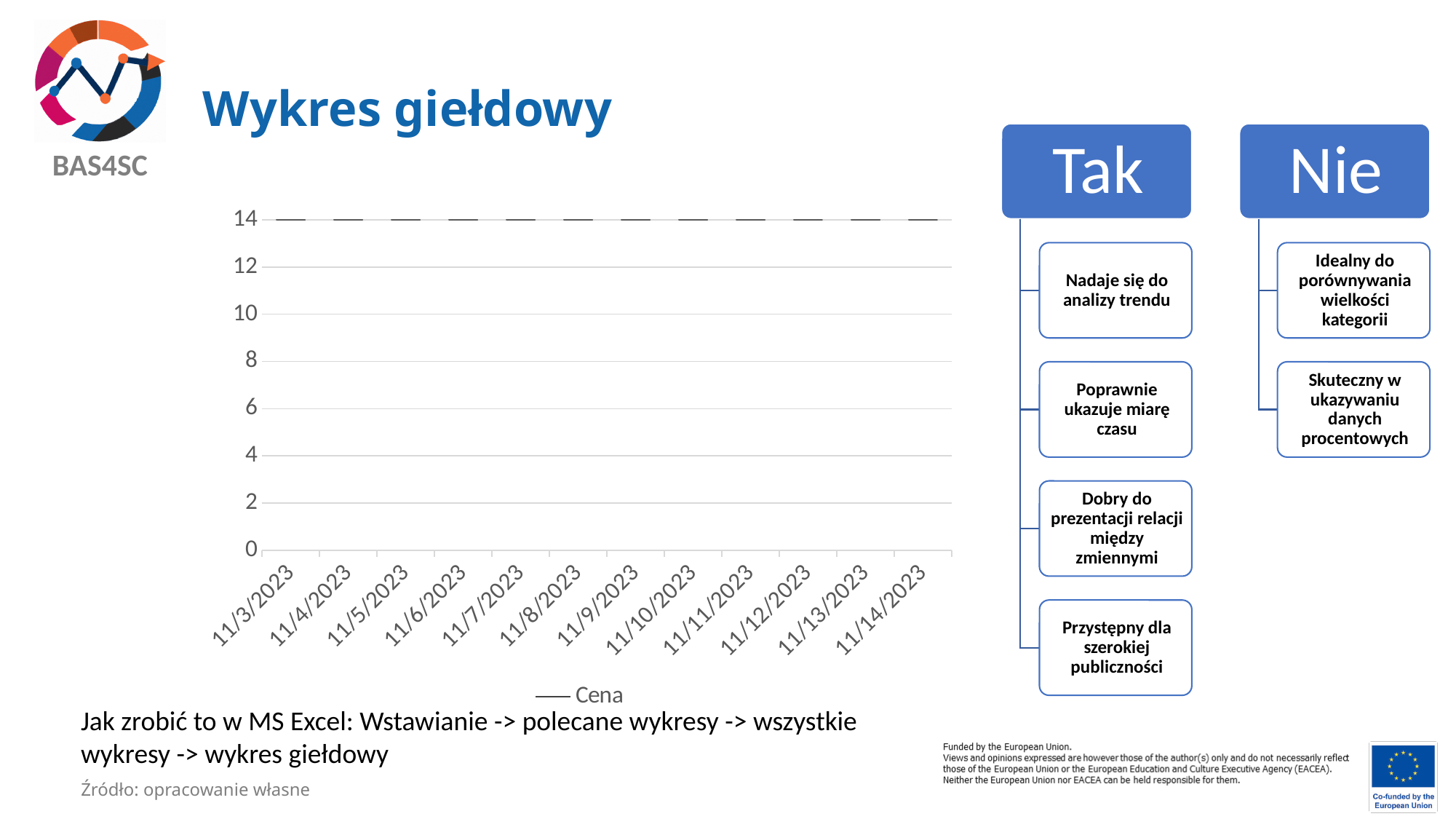
What is the name of the series shown in the chart legend? Cena What kind of chart is shown on the slide? stock chart What is the lowest value labelled on the y axis of the chart? 0 What is the first date shown on the x axis of the chart? 11/3/2023 What is the title of the chart on the slide? Wykres giełdowy How many series does the chart legend list? 1 What is the highest value labelled on the y axis of the chart? 14 How many dates are shown along the x axis of the chart? 12 What is the last date shown on the x axis of the chart? 11/14/2023